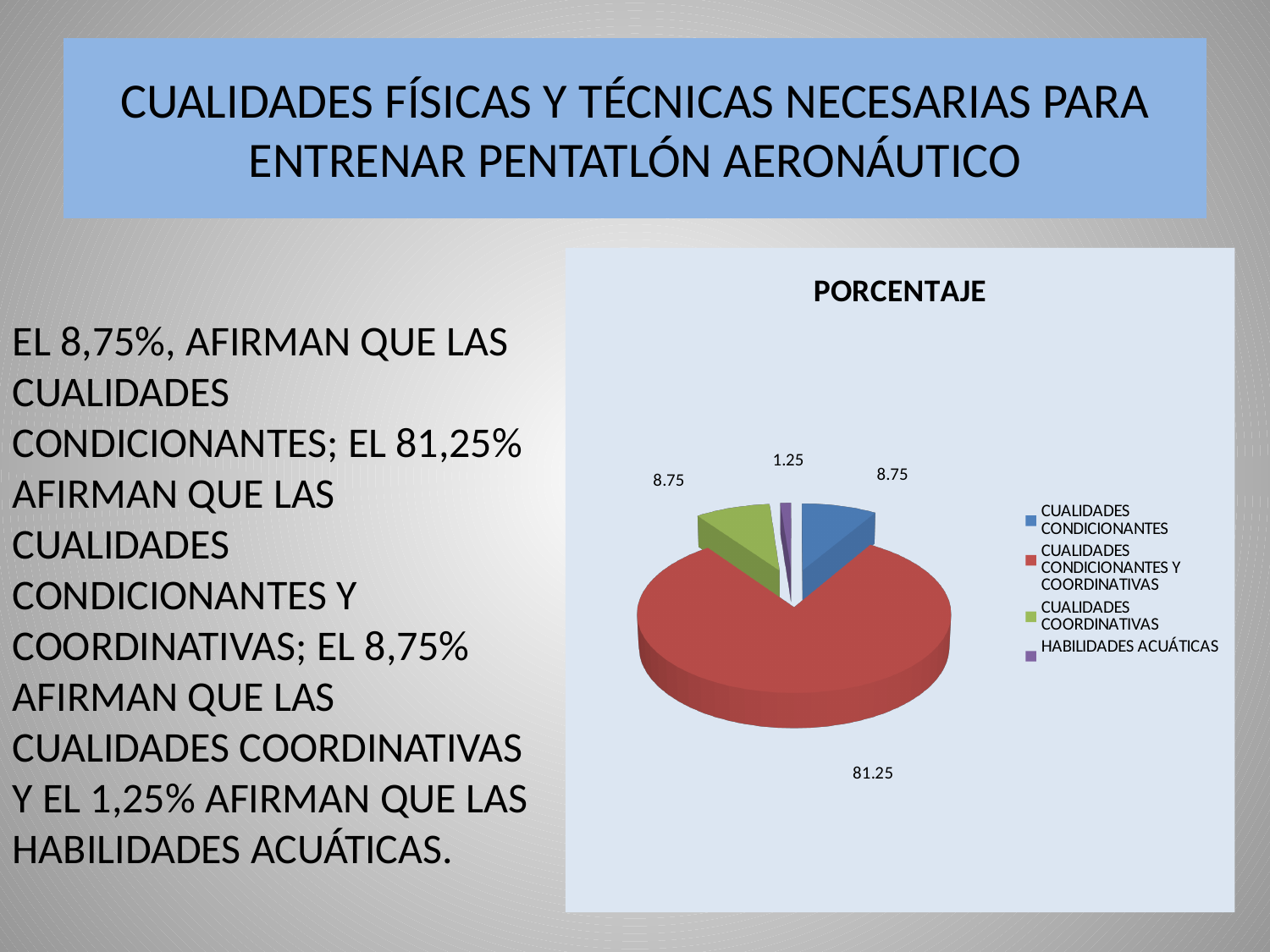
Which category has the smallest slice of the pie? HABILIDADES ACUÁTICAS What is the title of the chart? PORCENTAJE What is the value for HABILIDADES ACUÁTICAS? 1.25 Which category has the largest slice of the pie? CUALIDADES CONDICIONANTES Y COORDINATIVAS Which is larger, the value for CUALIDADES CONDICIONANTES or the value for HABILIDADES ACUÁTICAS? CUALIDADES CONDICIONANTES What is the value for CUALIDADES CONDICIONANTES Y COORDINATIVAS? 81.25 How many categories does the pie chart show? 4 What colour is the slice for CUALIDADES CONDICIONANTES Y COORDINATIVAS? red What is the difference between the values for CUALIDADES CONDICIONANTES Y COORDINATIVAS and CUALIDADES COORDINATIVAS? 72.5 What is the value for CUALIDADES CONDICIONANTES? 8.75 What is the value for CUALIDADES COORDINATIVAS? 8.75 What type of chart is shown on the slide? pie chart